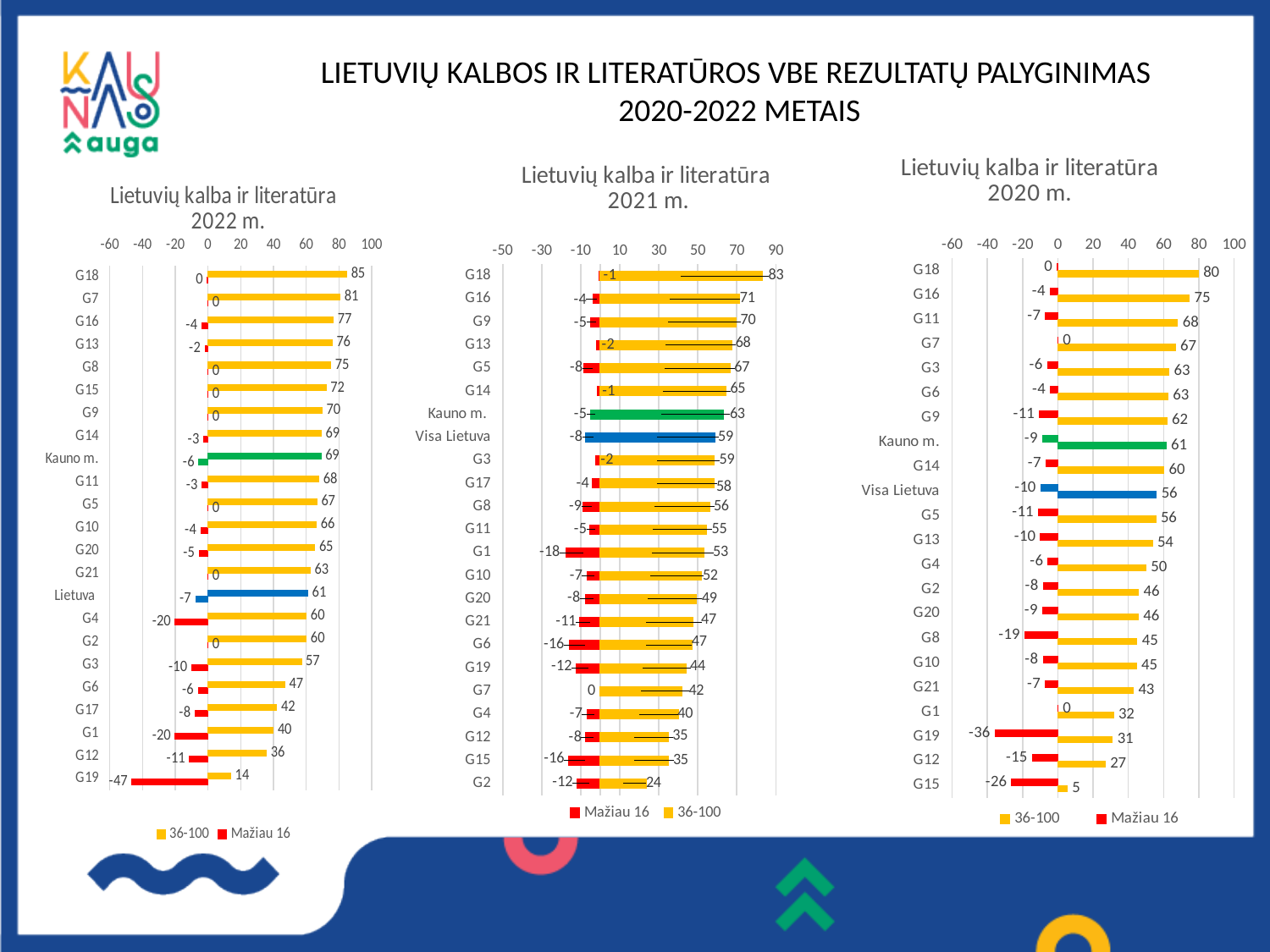
What type of chart is the 2020 m. chart? Bar chart In the 2021 m. chart, which category has the highest 36-100 value? G18 In the 2020 m. chart, what is the difference between the 36-100 values for G18 and G15? 75 In the 2020 m. chart, what is the 36-100 value for Visa Lietuva? 56 In the 2022 m. chart, what is the 36-100 value for G18? 85 In the 2022 m. chart, what is the difference between the 36-100 values for G18 and Lietuva? 24 In the 2020 m. chart, what is the Mažiau 16 value for G19? -36 In the 2021 m. chart, what is the Mažiau 16 value for G1? -18 In the 2022 m. chart, what is the Mažiau 16 value for G19? -47 In the 2021 m. chart, which has a larger 36-100 value, G16 or G9? G16 In the 2022 m. chart, which category has the lowest 36-100 value? G19 In the 2021 m. chart, what is the 36-100 value for Kauno m.? 63